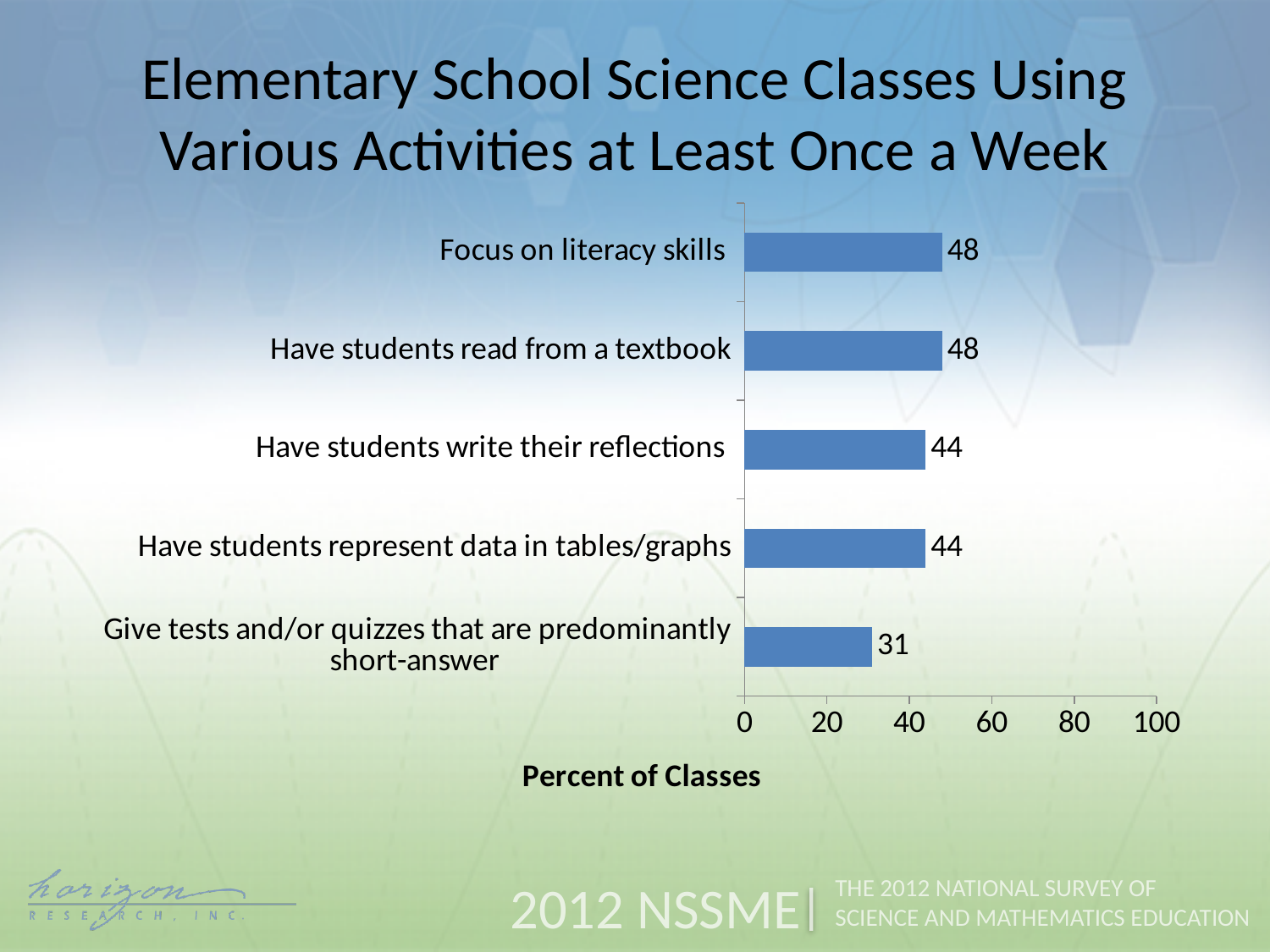
What is the difference between the value for 'Have students read from a textbook' and the value for 'Give tests and/or quizzes that are predominantly short-answer'? 17 What is the maximum value shown on the horizontal axis? 100 What is the difference between the value for 'Focus on literacy skills' and the value for 'Have students represent data in tables/graphs'? 4 What kind of chart is shown on the slide? Bar chart How many activities are shown in the chart? 5 Is the value for 'Have students represent data in tables/graphs' greater or less than 60? less Which is larger: the value for 'Have students write their reflections' or the value for 'Give tests and/or quizzes that are predominantly short-answer'? Have students write their reflections What percent of classes focus on literacy skills at least once a week? 48 What is the label of the horizontal axis? Percent of Classes Which activity has the lowest percent of classes? Give tests and/or quizzes that are predominantly short-answer What is the value for 'Give tests and/or quizzes that are predominantly short-answer'? 31 What is the value for 'Have students write their reflections'? 44